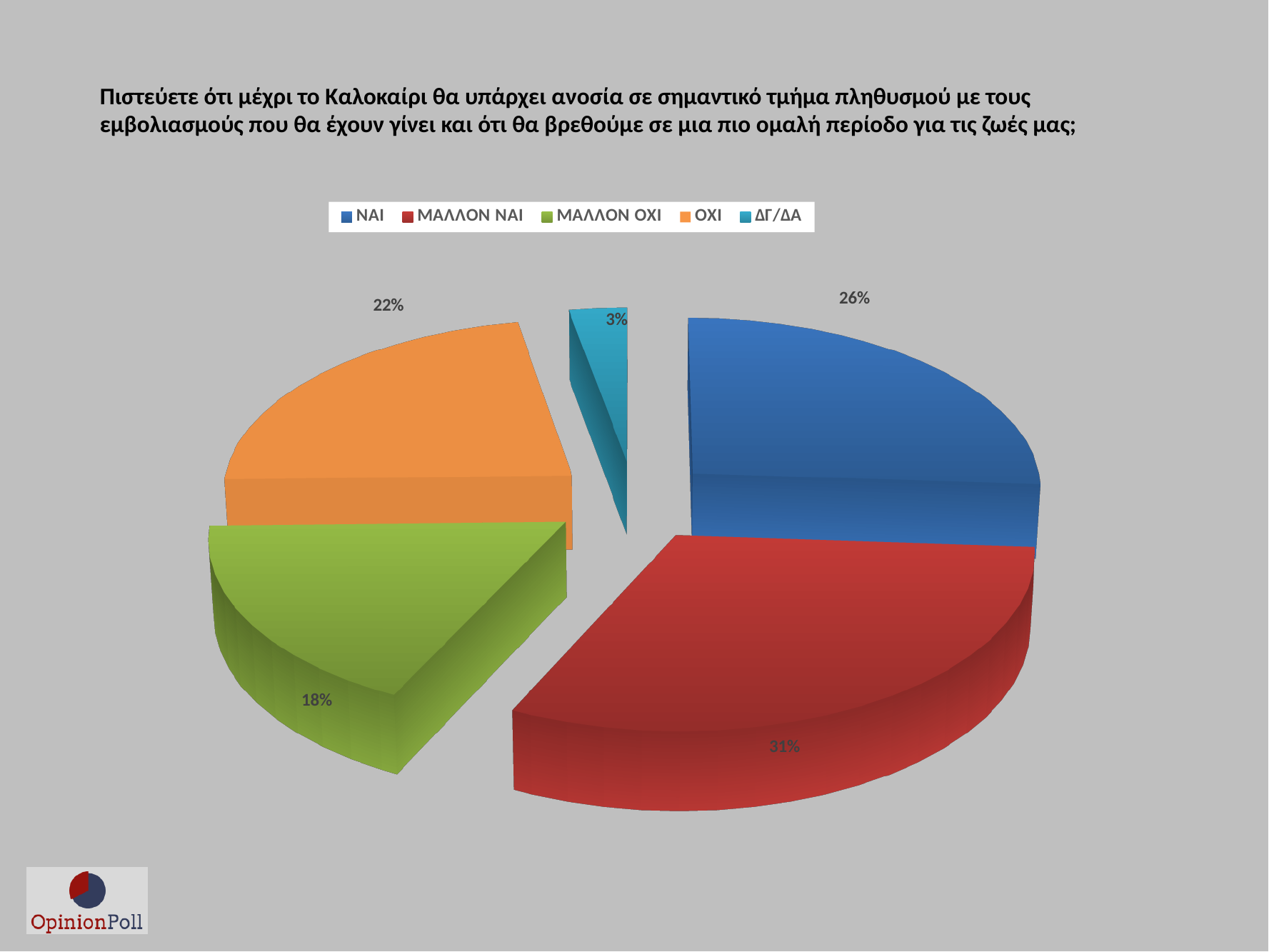
Which is larger, the share for ΟΧΙ or the share for ΜΑΛΛΟΝ ΟΧΙ? ΟΧΙ Which response has the largest share of the pie? ΜΑΛΛΟΝ ΝΑΙ Which response has the smallest share of the pie? ΔΓ/ΔΑ What percentage of respondents answered ΜΑΛΛΟΝ ΟΧΙ? 18% What percentage of respondents answered ΔΓ/ΔΑ? 3% What is the difference in percentage points between ΜΑΛΛΟΝ ΝΑΙ and ΝΑΙ? 5 What kind of chart is shown on the slide? pie chart What percentage of respondents answered ΜΑΛΛΟΝ ΝΑΙ? 31% What percentage of respondents answered ΝΑΙ? 26% Which colour represents ΟΧΙ in the legend? orange What percentage of respondents answered ΟΧΙ? 22% How many slices does the pie chart have? 5